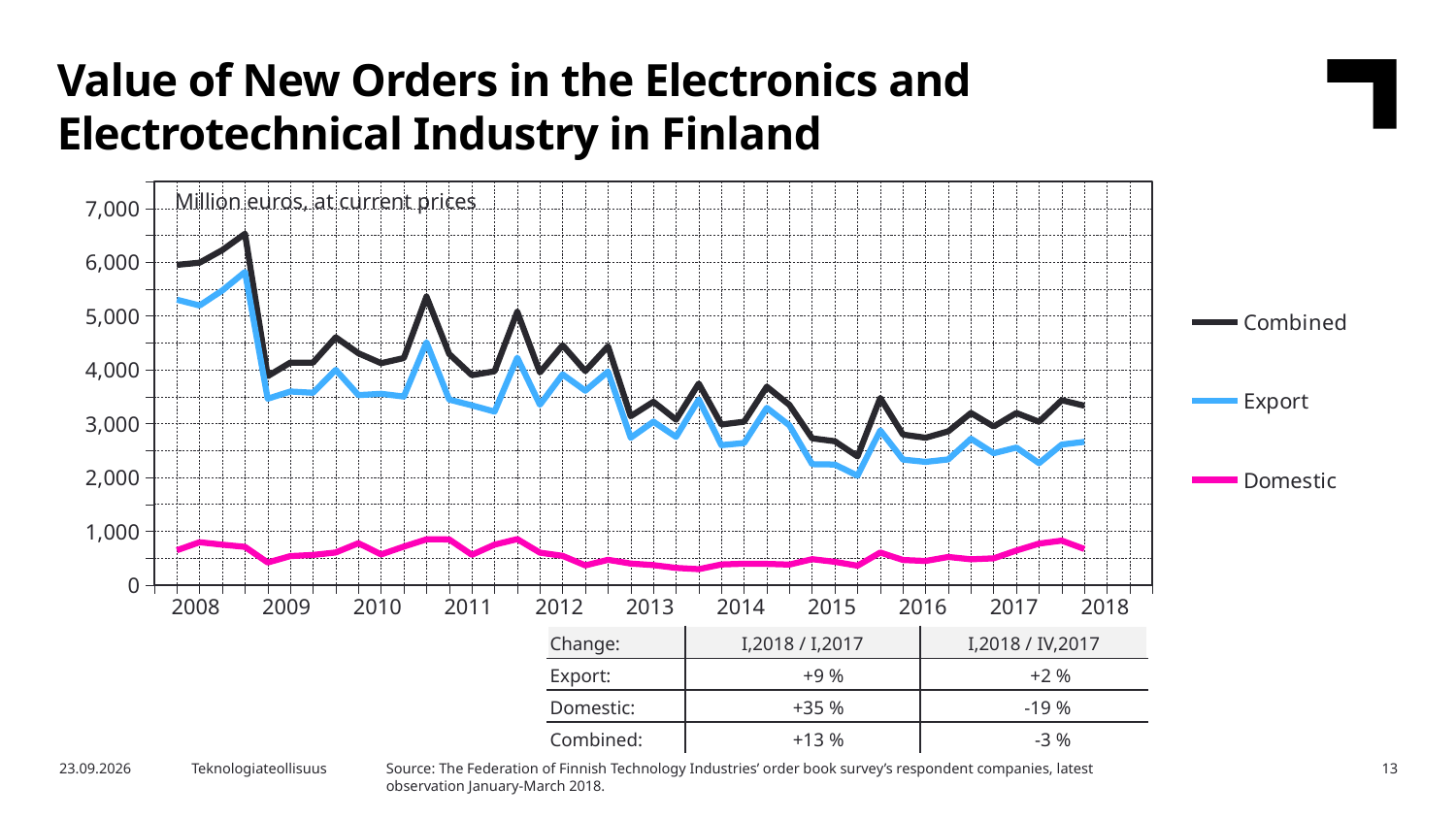
Is the highest value reached by the Combined series greater or less than 6,000? greater Is the Export value at the start of 2008 greater or less than 5,000? greater How many year labels are shown on the x axis? 11 What are the three series named in the chart's legend? Combined, Export, Domestic Overall, does the Combined series rise or fall from 2008 to 2018? fall Which series has the lowest values throughout the chart? Domestic Is the Domestic value at the start of 2008 greater or less than 1,000? less How many series does the chart's legend list? 3 What kind of chart is shown on the slide? line chart What unit label is printed inside the chart area? Million euros, at current prices